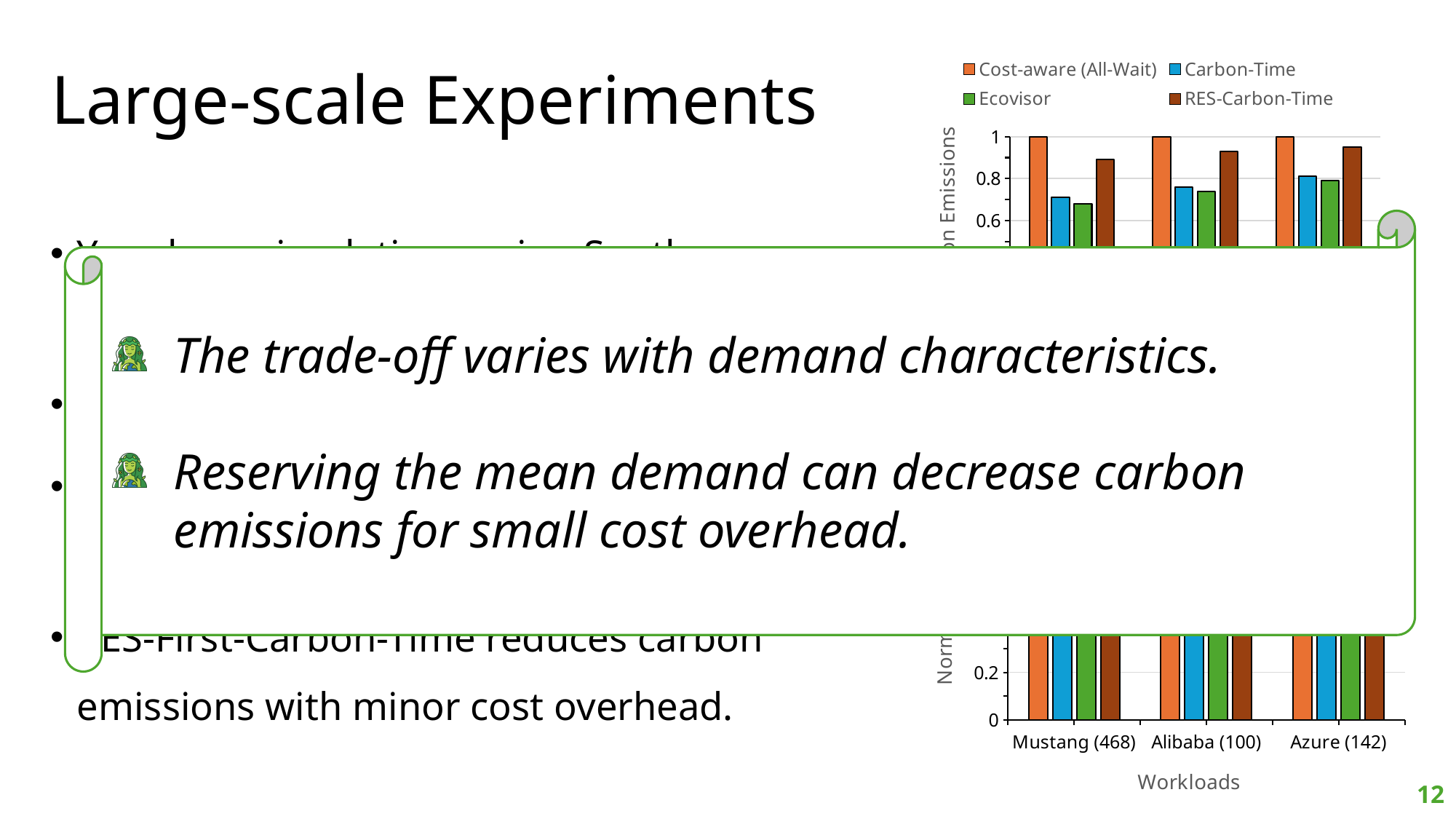
In the top (carbon emissions) chart, is the value for Carbon-Time for Mustang (468) greater or less than 0.8? less How many series does the chart legend list? 4 How many workloads are shown on the x axis of the chart? 3 In the top (carbon emissions) chart, do the Carbon-Time values rise or fall from Mustang (468) to Azure (142)? rise In the top (carbon emissions) chart, which is larger for Mustang (468): RES-Carbon-Time or Carbon-Time? RES-Carbon-Time What is the x-axis title of the chart? Workloads In the top (carbon emissions) chart, which series has the highest value for Alibaba (100)? Cost-aware (All-Wait) In the top (carbon emissions) chart, is the value for Ecovisor for Alibaba (100) greater or less than 0.8? less What kind of chart is shown on the right of the slide? bar chart In the top (carbon emissions) chart, is the value for RES-Carbon-Time for Mustang (468) greater or less than 0.8? greater In the top (carbon emissions) chart, what is the value for Cost-aware (All-Wait) for Mustang (468)? 1 In the top (carbon emissions) chart, what is the value for Cost-aware (All-Wait) for Azure (142)? 1